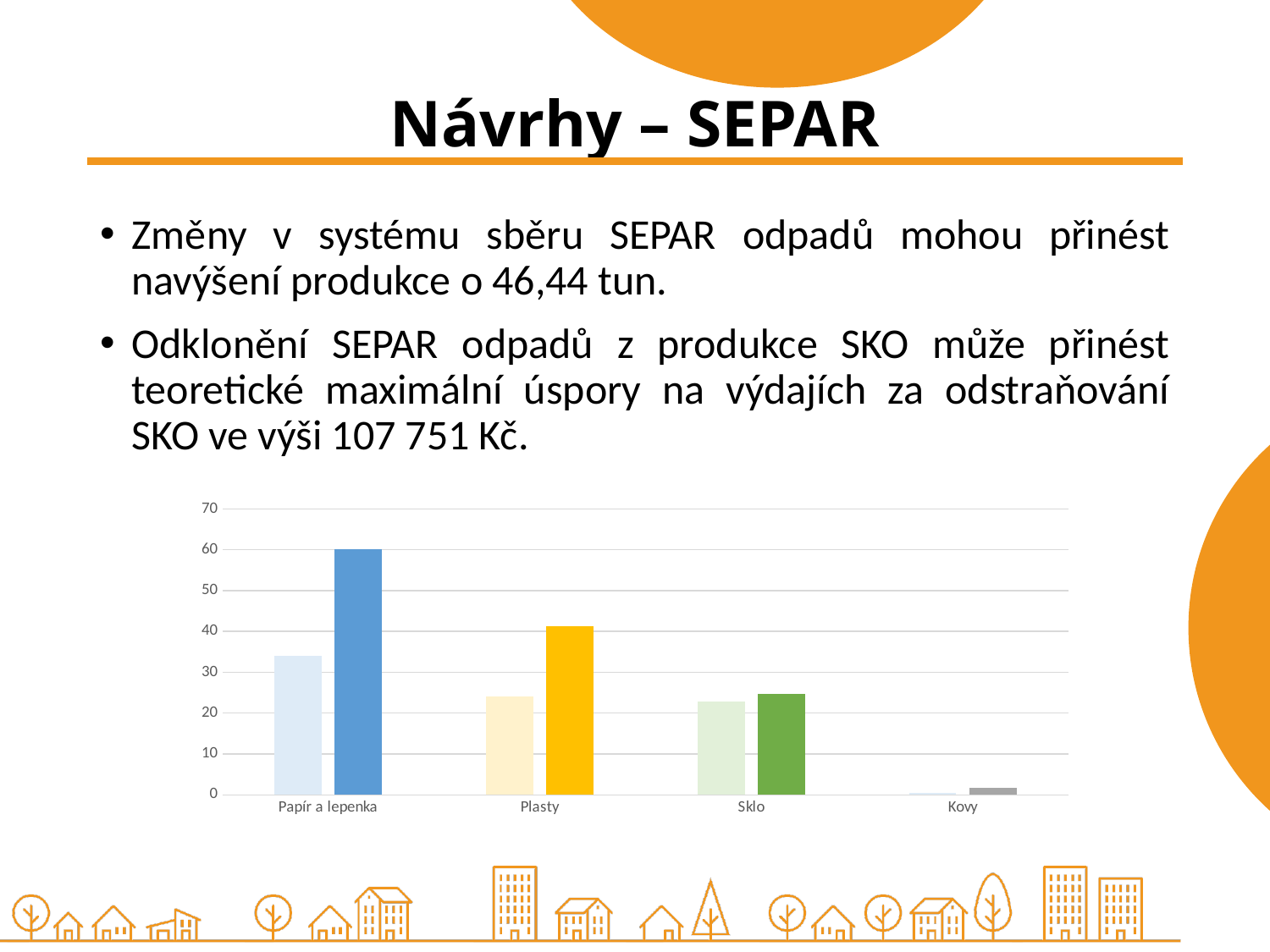
Which category has the lowest bars in the chart? Kovy How many categories are shown on the x axis of the chart? 4 Which category has the tallest bar in the chart? Papír a lepenka Is the value of the lighter (left) bar for Papír a lepenka greater or less than 30? greater What is the highest value shown on the y axis of the chart? 70 Is the value of the darker (right) bar for Papír a lepenka greater or less than 50? greater Is the value of the darker (right) bar for Sklo greater or less than 30? less Which is larger: the darker (right) bar for Plasty or the darker (right) bar for Sklo? Plasty What kind of chart is shown on the slide? bar chart Which is larger: the lighter (left) bar for Papír a lepenka or the lighter (left) bar for Plasty? Papír a lepenka